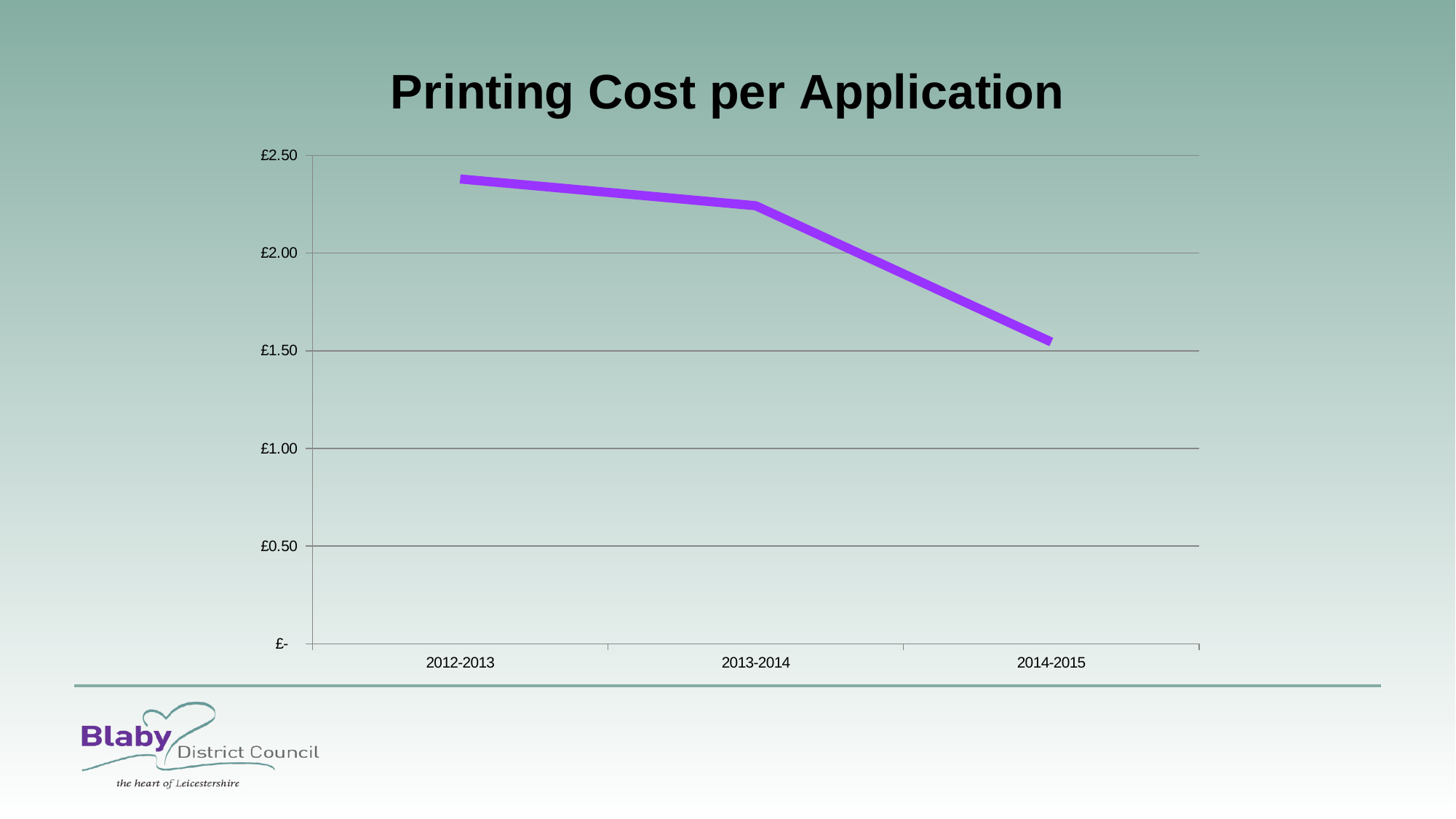
Which year has the highest printing cost per application? 2012-2013 Does the printing cost per application rise or fall from 2012-2013 to 2014-2015? fall Is the value for 2013-2014 greater or less than £2.00? greater What is the title of the chart? Printing Cost per Application Is the value for 2013-2014 greater or less than £2.50? less Which is larger, the value for 2012-2013 or the value for 2014-2015? 2012-2013 How many years are plotted on the x axis? 3 Is the value for 2014-2015 greater or less than £2.00? less Which year has the lowest printing cost per application? 2014-2015 What colour is the line in the chart? purple What kind of chart is shown on the slide? line chart